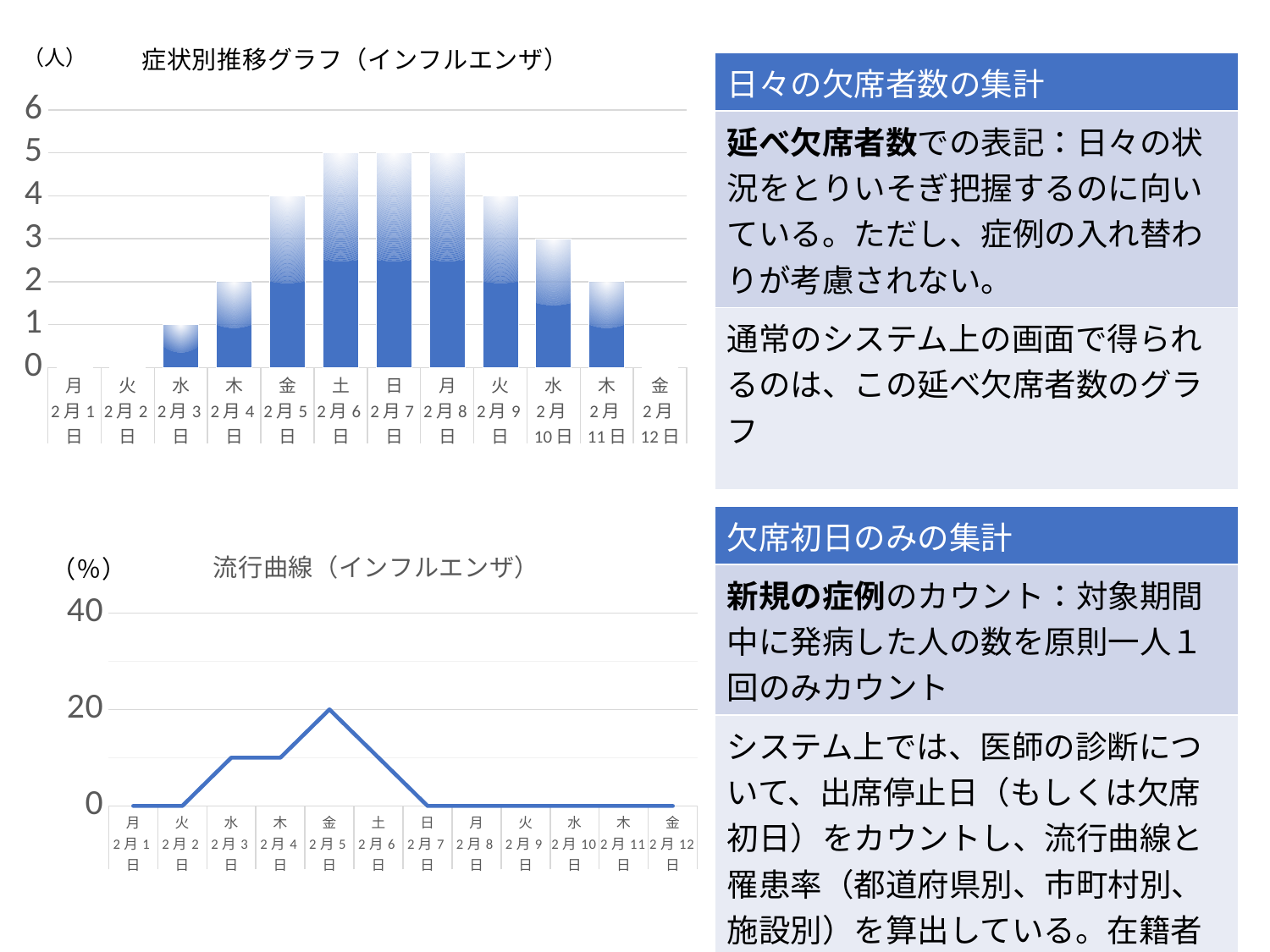
In the bottom chart 流行曲線（インフルエンザ）, is the value for 2月3日 greater or less than 20? less In the bottom chart 流行曲線（インフルエンザ）, what is the value for 2月5日? 20 How many dates are shown on the x axis of the top chart 症状別推移グラフ（インフルエンザ）? 12 In the top chart 症状別推移グラフ（インフルエンザ）, which is larger, the value for 2月5日 or the value for 2月10日? 2月5日 What unit is shown on the y axis of the bottom chart 流行曲線（インフルエンザ）? (%) In the top chart 症状別推移グラフ（インフルエンザ）, what is the value for 2月6日? 5 In the bottom chart 流行曲線（インフルエンザ）, which date has the highest value? 2月5日 In the top chart 症状別推移グラフ（インフルエンザ）, what is the value for 2月10日? 3 What kind of chart is the bottom chart titled 流行曲線（インフルエンザ）? line chart In the top chart 症状別推移グラフ（インフルエンザ）, do the values rise or fall from 2月8日 to 2月11日? fall What kind of chart is the top chart titled 症状別推移グラフ（インフルエンザ）? bar chart In the top chart 症状別推移グラフ（インフルエンザ）, what is the difference between the values for 2月6日 and 2月3日? 4